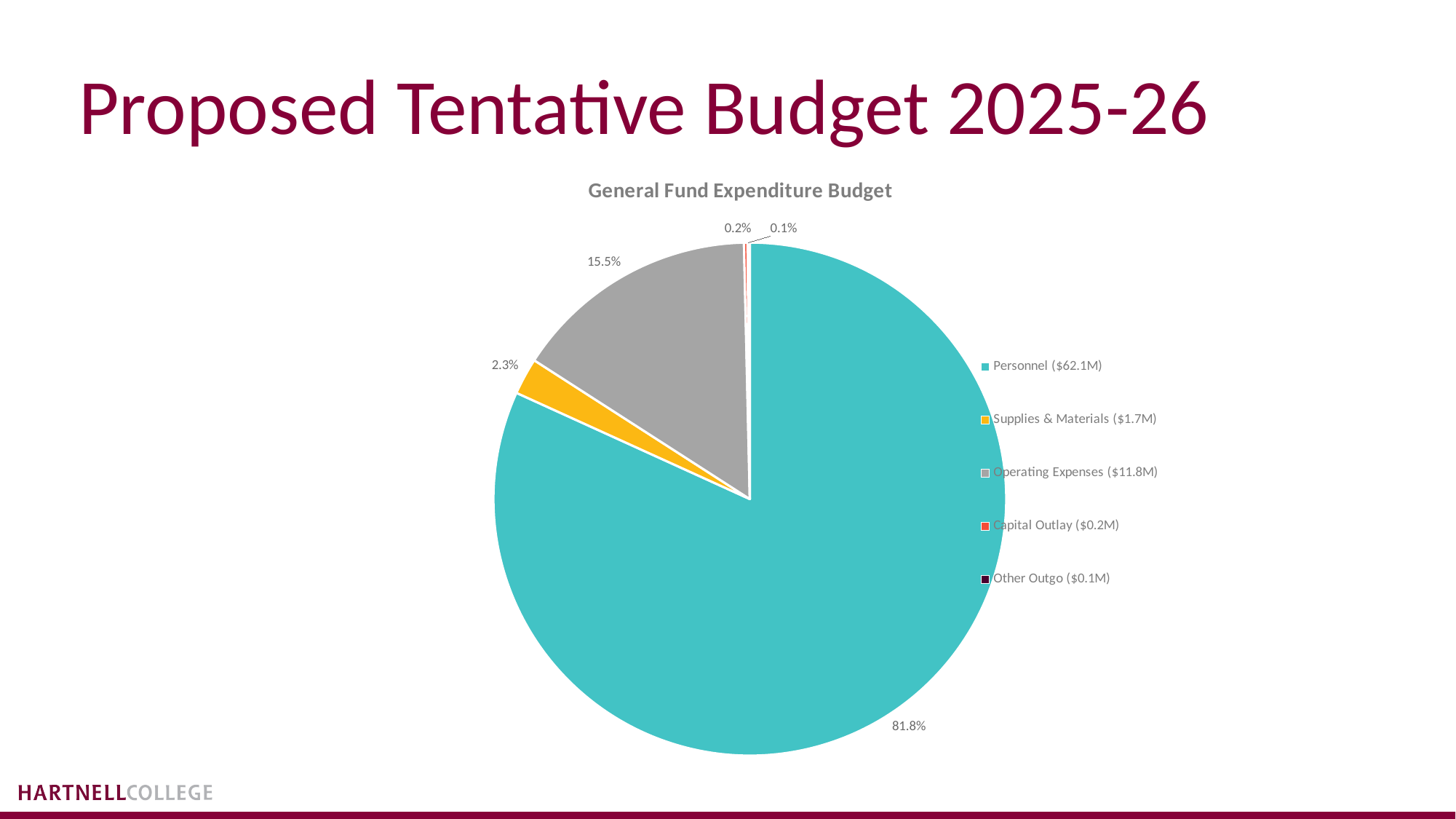
What percentage of the General Fund Expenditure Budget is Operating Expenses? 15.5% What percentage of the General Fund Expenditure Budget is Personnel? 81.8% What is the title of the chart? General Fund Expenditure Budget What dollar amount does the legend show for Operating Expenses? $11.8M What percentage of the General Fund Expenditure Budget is Supplies & Materials? 2.3% What percentage of the General Fund Expenditure Budget is Capital Outlay? 0.2% Which is larger, the share for Supplies & Materials or the share for Operating Expenses? Operating Expenses What kind of chart is shown on the slide? Pie chart Which category has the largest share of the General Fund Expenditure Budget? Personnel What is the difference in percentage points between the Personnel share and the Operating Expenses share? 66.3 Which category has the smallest share of the General Fund Expenditure Budget? Other Outgo How many categories does the legend list? 5